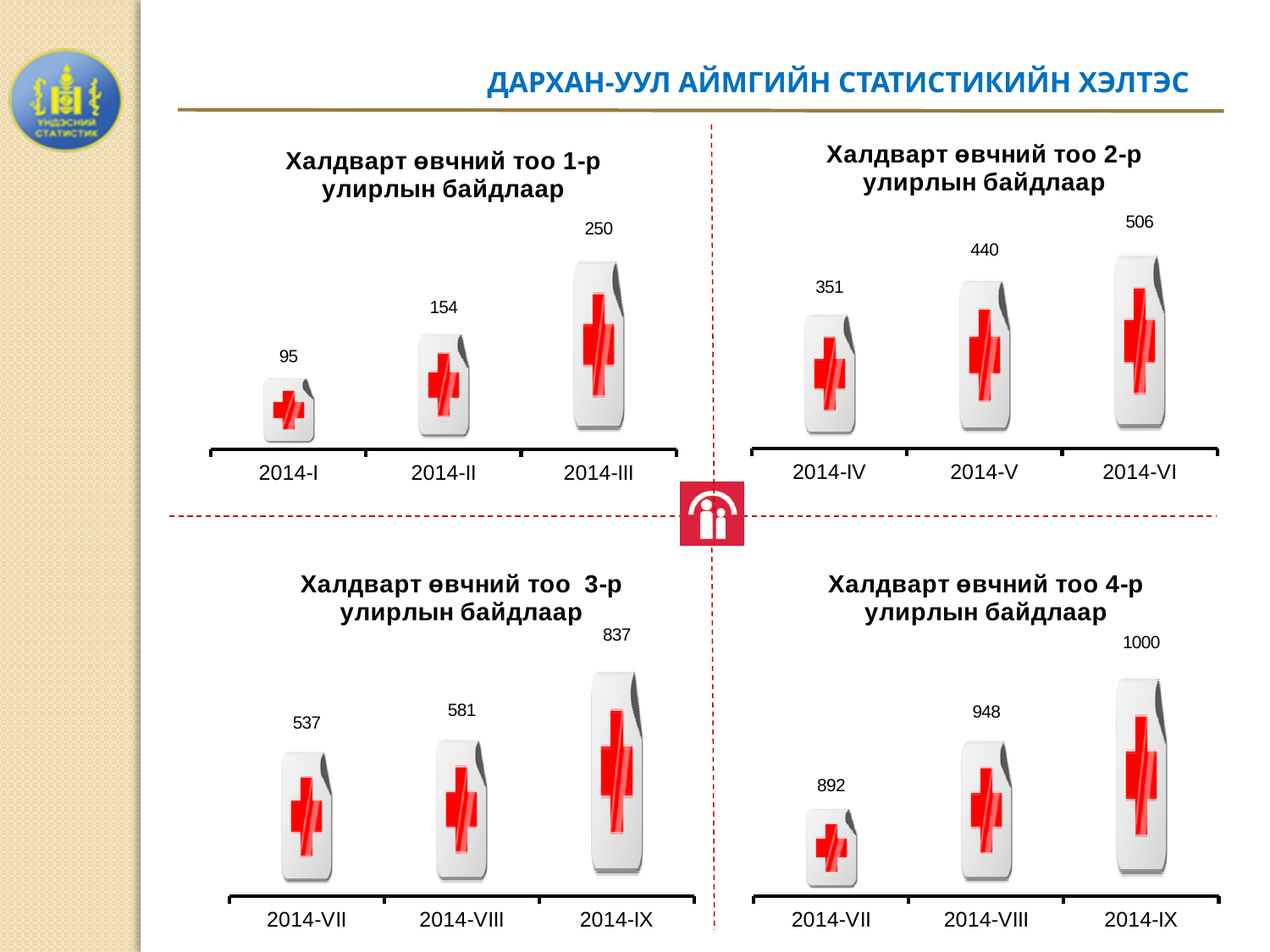
In the bottom-right chart (Халдварт өвчний тоо 4-р улирлын байдлаар), what is the value for the first bar, labelled 2014-VII? 892 In the top-left chart (Халдварт өвчний тоо 1-р улирлын байдлаар), what is the value for 2014-II? 154 In the top-right chart (Халдварт өвчний тоо 2-р улирлын байдлаар), what is the value for 2014-V? 440 In the bottom-right chart (Халдварт өвчний тоо 4-р улирлын байдлаар), which is larger, the value for 2014-VIII or the value for 2014-IX? 2014-IX In the top-left chart (Халдварт өвчний тоо 1-р улирлын байдлаар), which category has the highest value? 2014-III In the bottom-left chart (Халдварт өвчний тоо 3-р улирлын байдлаар), what is the difference between the values for 2014-VIII and 2014-VII? 44 In the top-right chart (Халдварт өвчний тоо 2-р улирлын байдлаар), do the values rise or fall from 2014-IV to 2014-VI? rise How many categories are shown in the bottom-left chart (Халдварт өвчний тоо 3-р улирлын байдлаар)? 3 What kind of chart is the top-left chart (Халдварт өвчний тоо 1-р улирлын байдлаар)? bar chart In the bottom-left chart (Халдварт өвчний тоо 3-р улирлын байдлаар), what is the value for 2014-IX? 837 In the top-left chart (Халдварт өвчний тоо 1-р улирлын байдлаар), what is the difference between the values for 2014-III and 2014-I? 155 In the top-right chart (Халдварт өвчний тоо 2-р улирлын байдлаар), which category has the lowest value? 2014-IV